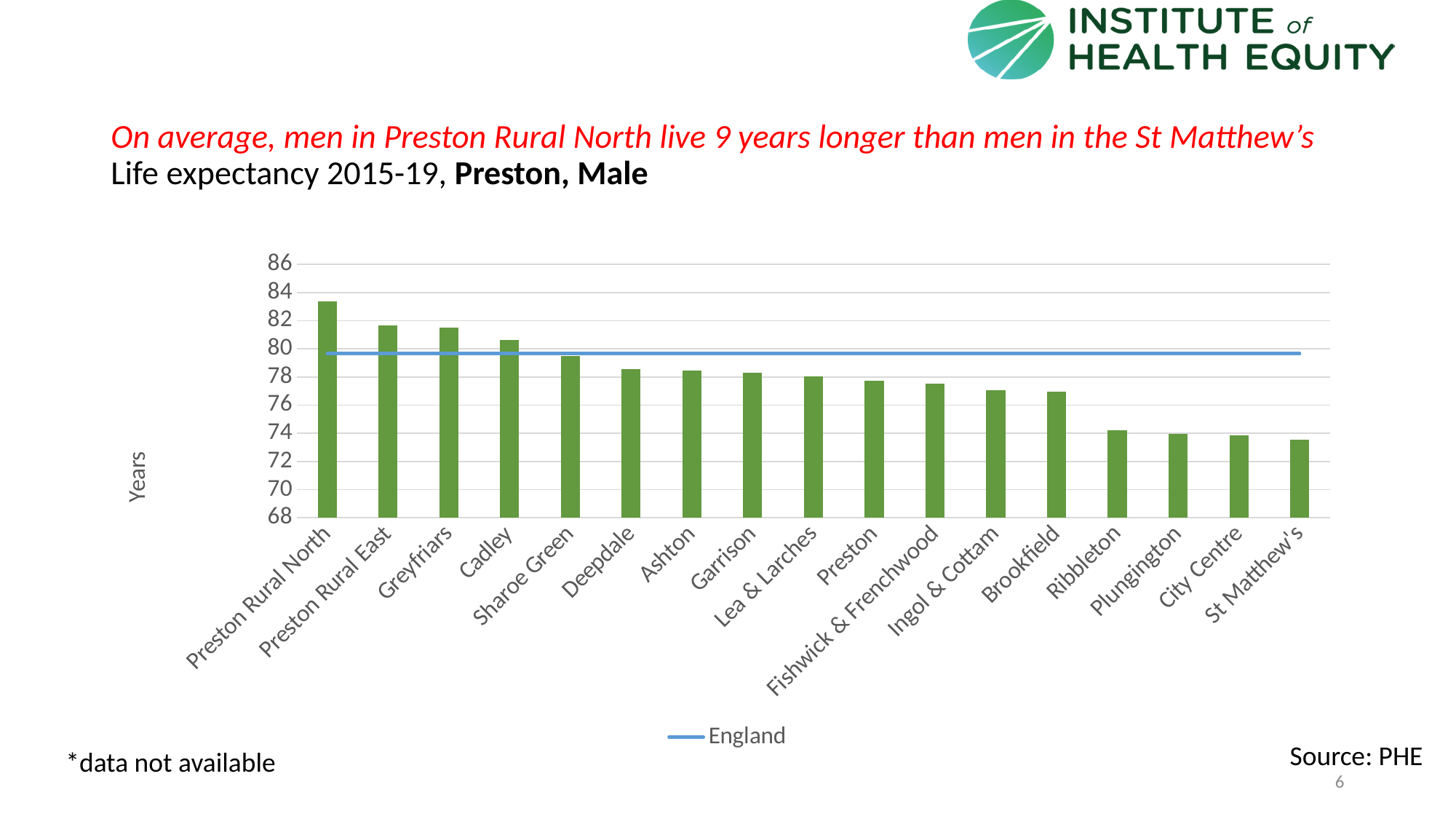
Is the value for St Matthew's greater or less than 74? less Do the bar values rise or fall from left to right along the x axis? Fall Which has the higher male life expectancy, Brookfield or Ribbleton? Brookfield Which ward has the lowest male life expectancy on the chart? St Matthew's What kind of chart is shown on the slide? Combination bar and line chart (bars with an England line) Is the value for Greyfriars greater or less than 80? greater How many wards (bars) are plotted on the chart? 17 Is the value for Preston Rural North greater or less than 82? greater Which has the higher male life expectancy, Cadley or Sharoe Green? Cadley Which ward has the highest male life expectancy on the chart? Preston Rural North What series does the legend list? England